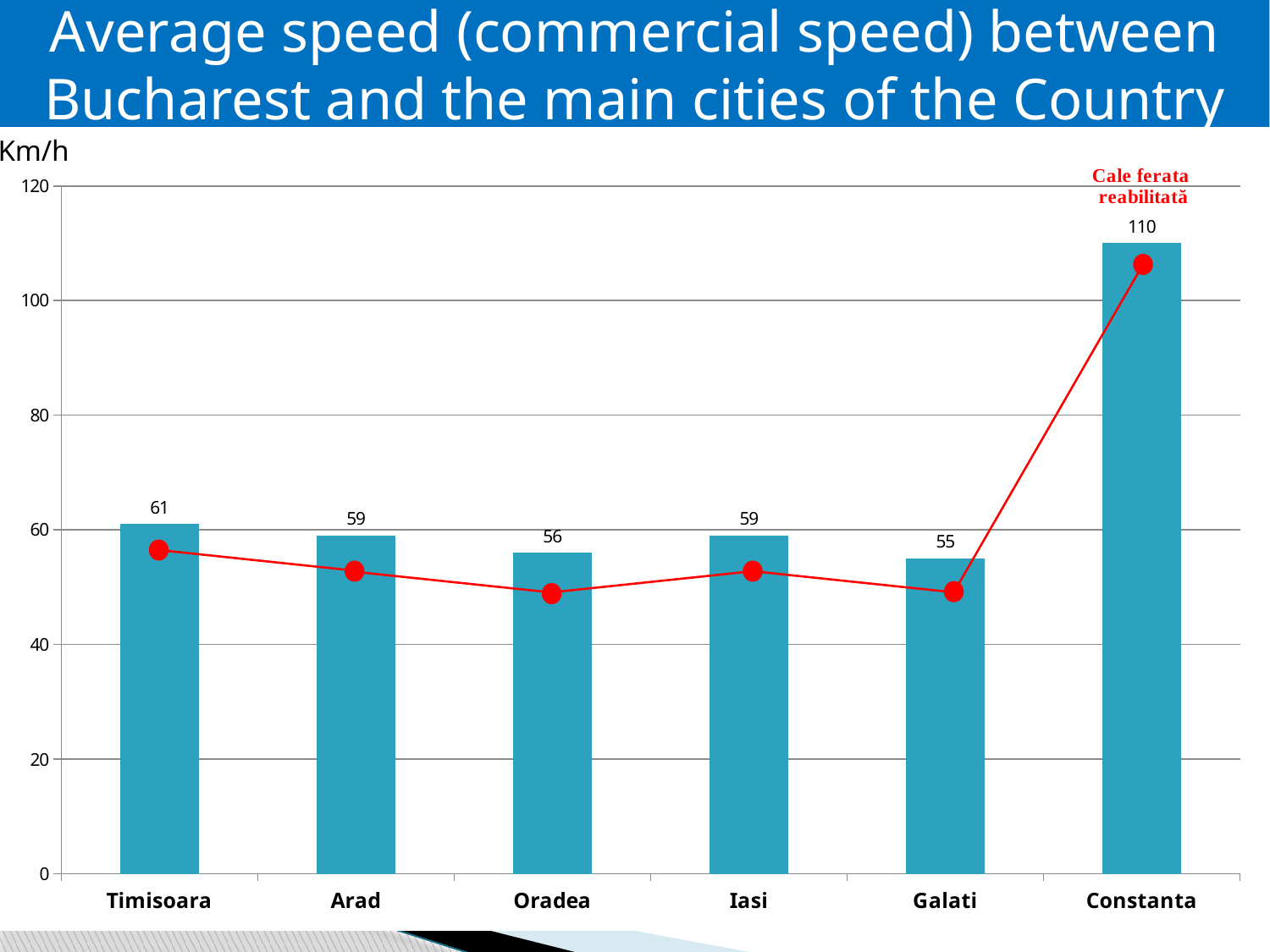
Which is larger, the average speed to Timisoara or to Oradea? Timisoara What unit is shown at the top of the vertical axis? Km/h What is the average speed between Bucharest and Timisoara? 61 What is the average speed between Bucharest and Oradea? 56 How many cities are shown on the x axis? 6 What kind of chart is used to show the average speeds? bar chart Which city has the lowest average speed from Bucharest? Galati Which city has the highest average speed from Bucharest? Constanta What is the average speed between Bucharest and Galati? 55 What is the average speed between Bucharest and Constanta? 110 What is the difference between the average speed to Constanta and the average speed to Timisoara? 49 Is the value of the red line marker for Constanta greater or less than 100? greater